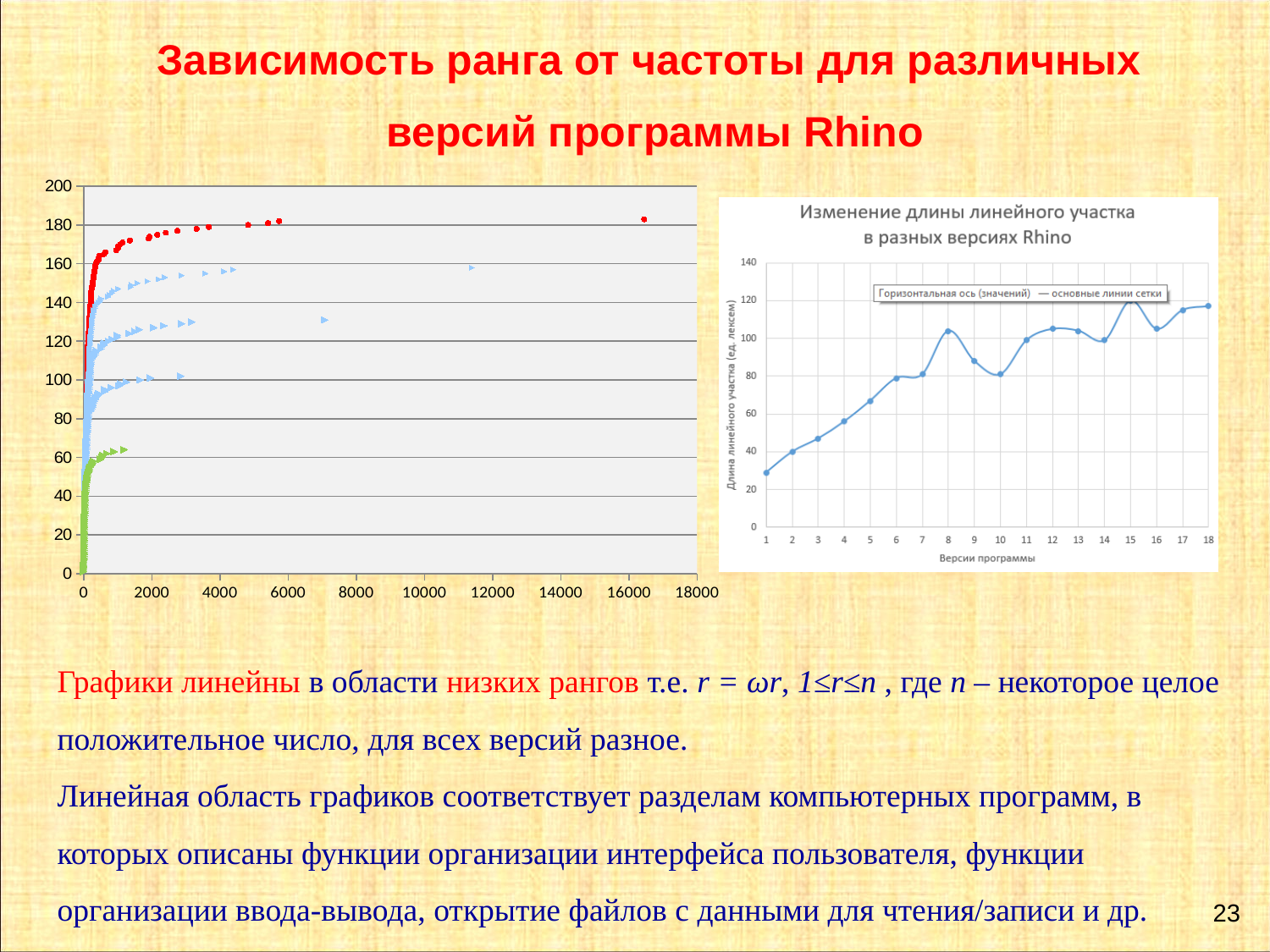
In the right chart 'Изменение длины линейного участка в разных версиях Rhino', do the values generally rise or fall from version 1 to version 18? rise What is the title of the chart on the right side of the slide? Изменение длины линейного участка в разных версиях Rhino In the right chart 'Изменение длины линейного участка в разных версиях Rhino', which is larger: the value for version 8 or the value for version 9? version 8 In the right chart 'Изменение длины линейного участка в разных версиях Rhino', is the value for version 1 greater or less than 40? less What is the x-axis label of the right chart 'Изменение длины линейного участка в разных версиях Rhino'? Версии программы In the right chart 'Изменение длины линейного участка в разных версиях Rhino', which program version has the lowest value? 1 In the right chart 'Изменение длины линейного участка в разных версиях Rhino', is the value for version 10 greater or less than 100? less In the left chart, is the highest red point greater or less than 160 on the vertical axis? greater In the right chart 'Изменение длины линейного участка в разных версиях Rhino', how many program versions are plotted along the x axis? 18 What kind of chart is the chart on the left side of the slide? scatter chart